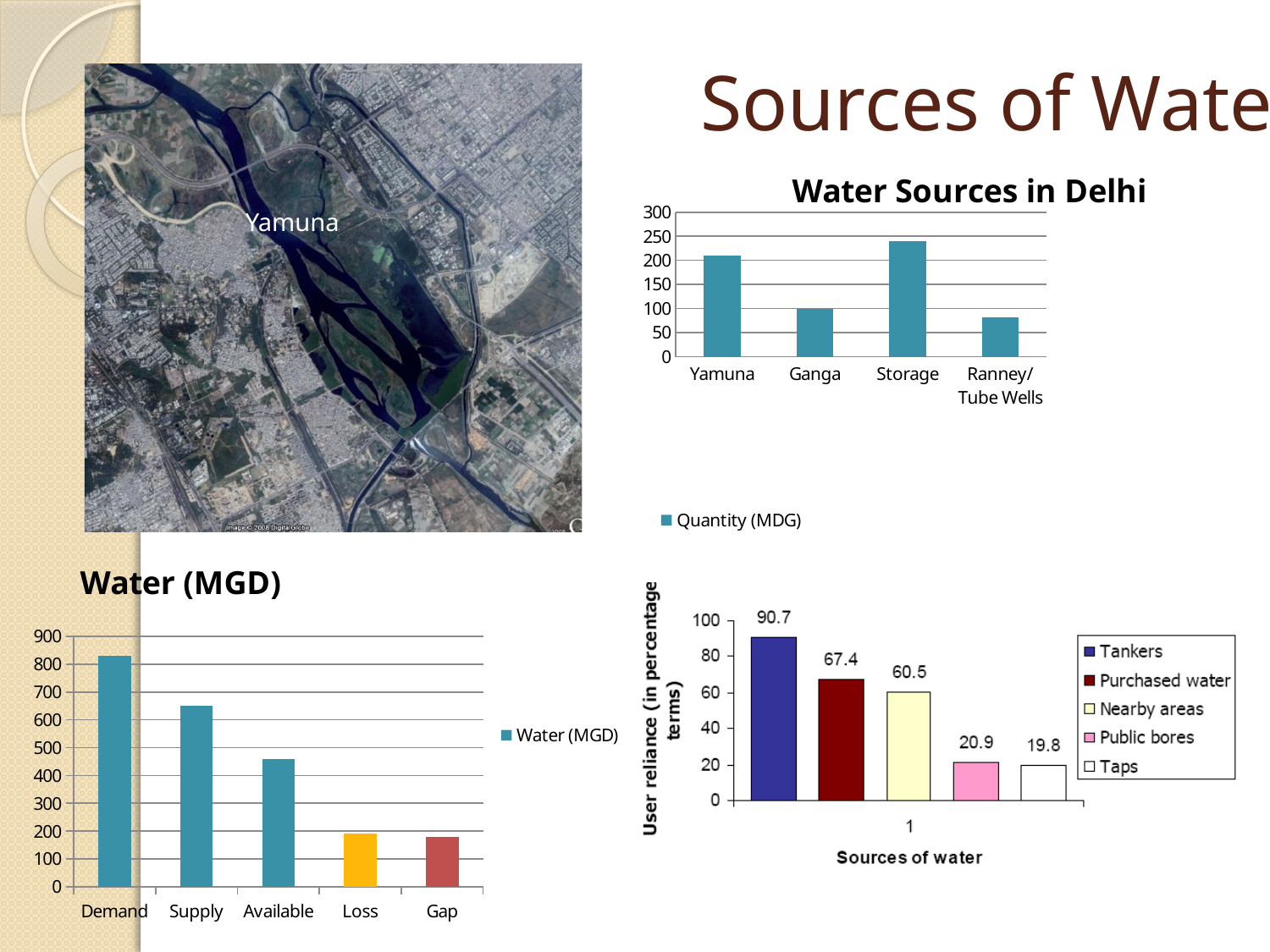
In the 'Water (MGD)' chart, how many categories are shown on the x axis? 5 In the bottom-right chart of user reliance on sources of water, what is the difference between the values for Tankers and Purchased water? 23.3 In the 'Water Sources in Delhi' chart, which source has the lowest quantity? Ranney/ Tube Wells In the 'Water (MGD)' chart, which category has the highest value? Demand In the 'Water (MGD)' chart, is the value for Supply greater or less than 600? greater In the 'Water Sources in Delhi' chart, how many sources are shown? 4 In the 'Water Sources in Delhi' chart, is the value for Yamuna greater or less than 200? greater In the 'Water (MGD)' chart, is the value for Available greater or less than 500? less In the bottom-right chart of user reliance on sources of water, what is the value for Purchased water? 67.4 In the 'Water Sources in Delhi' chart, which source has the highest quantity? Storage In the 'Water Sources in Delhi' chart, what is the value for Ganga? 100 In the bottom-right chart of user reliance on sources of water, how many series does the legend list? 5